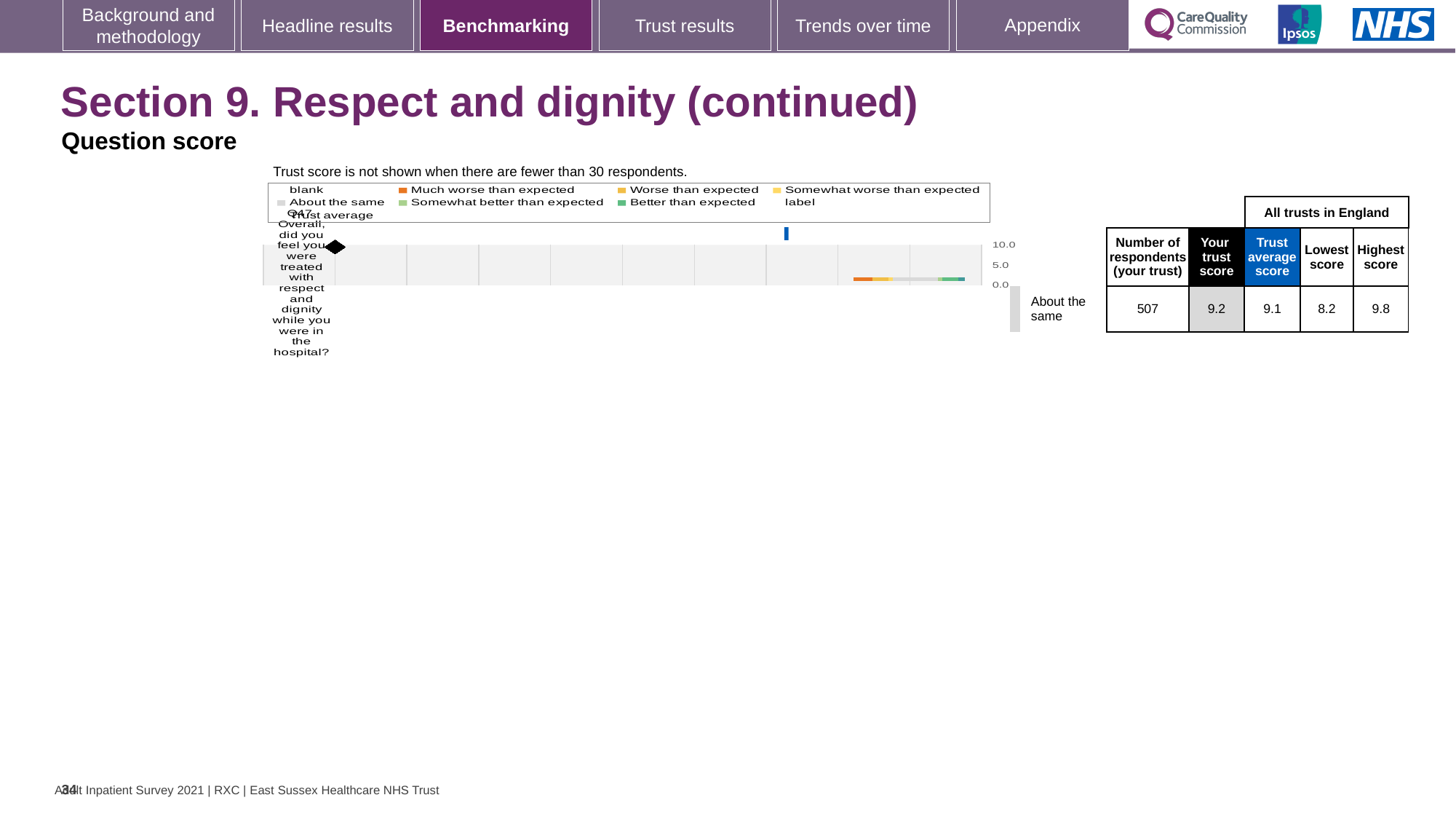
What is the trust average score for Q47 across all trusts in England? 9.1 What is the highest tick value shown on the chart's score axis? 10.0 What kind of chart is used to show the Q47 benchmarking result? bar chart What question number is shown on the chart? Q47 What is the lowest score for Q47 among all trusts in England? 8.2 What is the highest score for Q47 among all trusts in England? 9.8 What is your trust score for Q47? 9.2 How many respondents from your trust answered Q47? 507 What is the difference between your trust score and the lowest score for Q47? 1.0 What is the difference between the highest score and the lowest score for Q47? 1.6 Which is larger for Q47: your trust score or the trust average score? Your trust score What benchmark category is your trust's Q47 score placed in? About the same